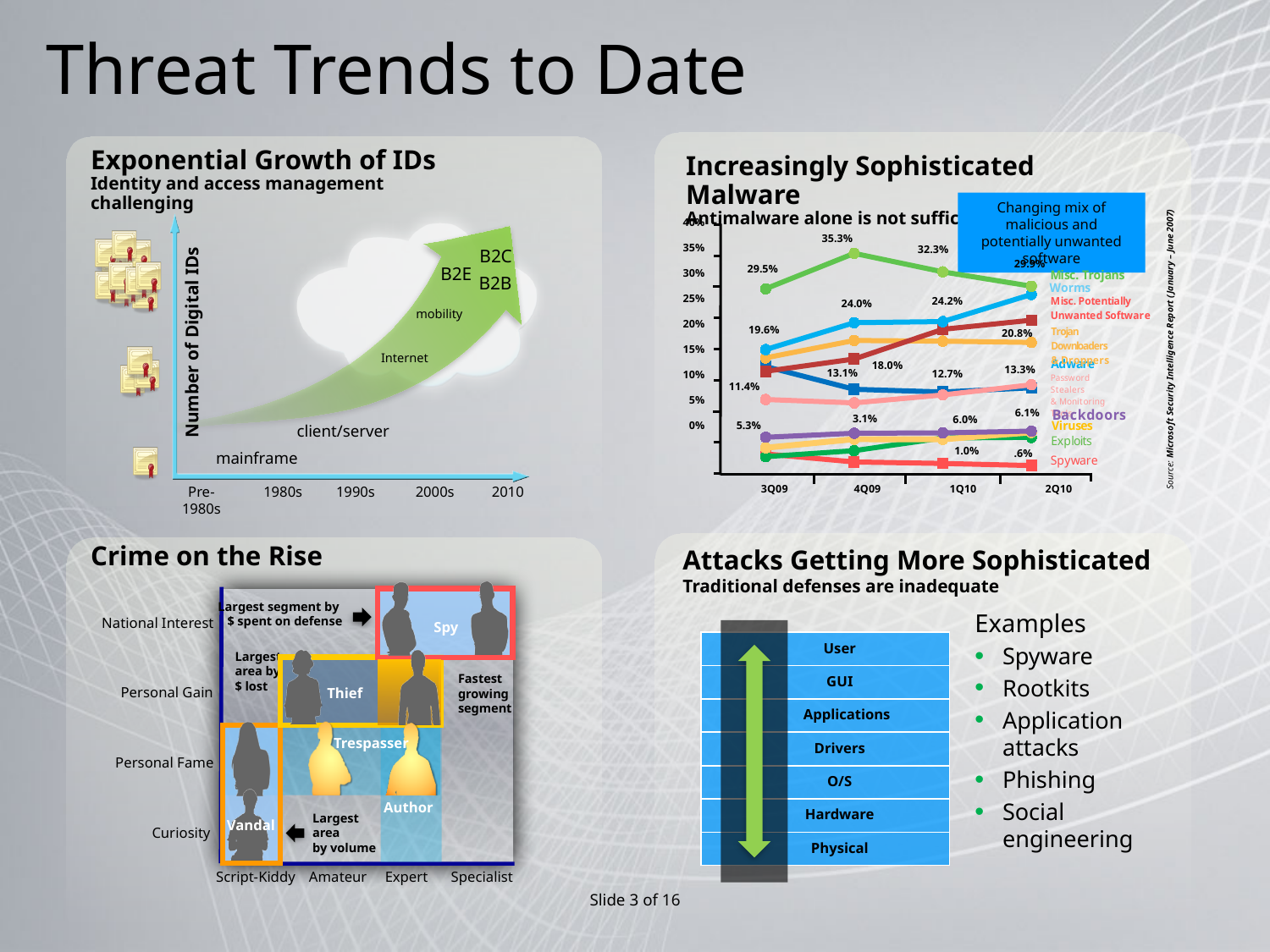
In the 'Increasingly Sophisticated Malware' chart, what is the value of the top (Misc. Trojans) line in 4Q09? 35.3% In the 'Increasingly Sophisticated Malware' chart, what is the highest percentage tick shown on the y axis? 40% In the 'Increasingly Sophisticated Malware' chart, what is the difference between the top line's 4Q09 value (35.3%) and its 2Q10 value (29.9%)? 5.4 percentage points In the 'Increasingly Sophisticated Malware' chart, does the top (Misc. Trojans) line rise or fall from 1Q10 to 2Q10? fall In the 'Increasingly Sophisticated Malware' chart, in which quarter does the top (Misc. Trojans) line reach its highest value? 4Q09 In the 'Increasingly Sophisticated Malware' chart, is the top line's value higher in 1Q10 or in 2Q10? 1Q10 In the 'Increasingly Sophisticated Malware' chart, what kind of chart is used to show the malware categories over time? line chart In the 'Increasingly Sophisticated Malware' chart, what is the value labelled on the lowest line in 2Q10? .6% In the 'Increasingly Sophisticated Malware' chart, is the top line's value in 4Q09 greater or less than 30%? greater In the 'Increasingly Sophisticated Malware' chart, what is the first quarter label on the x axis? 3Q09 In the 'Increasingly Sophisticated Malware' chart, how many quarters are shown on the x axis? 4 In the 'Increasingly Sophisticated Malware' chart, what is the value of the top (Misc. Trojans) line in 3Q09? 29.5%